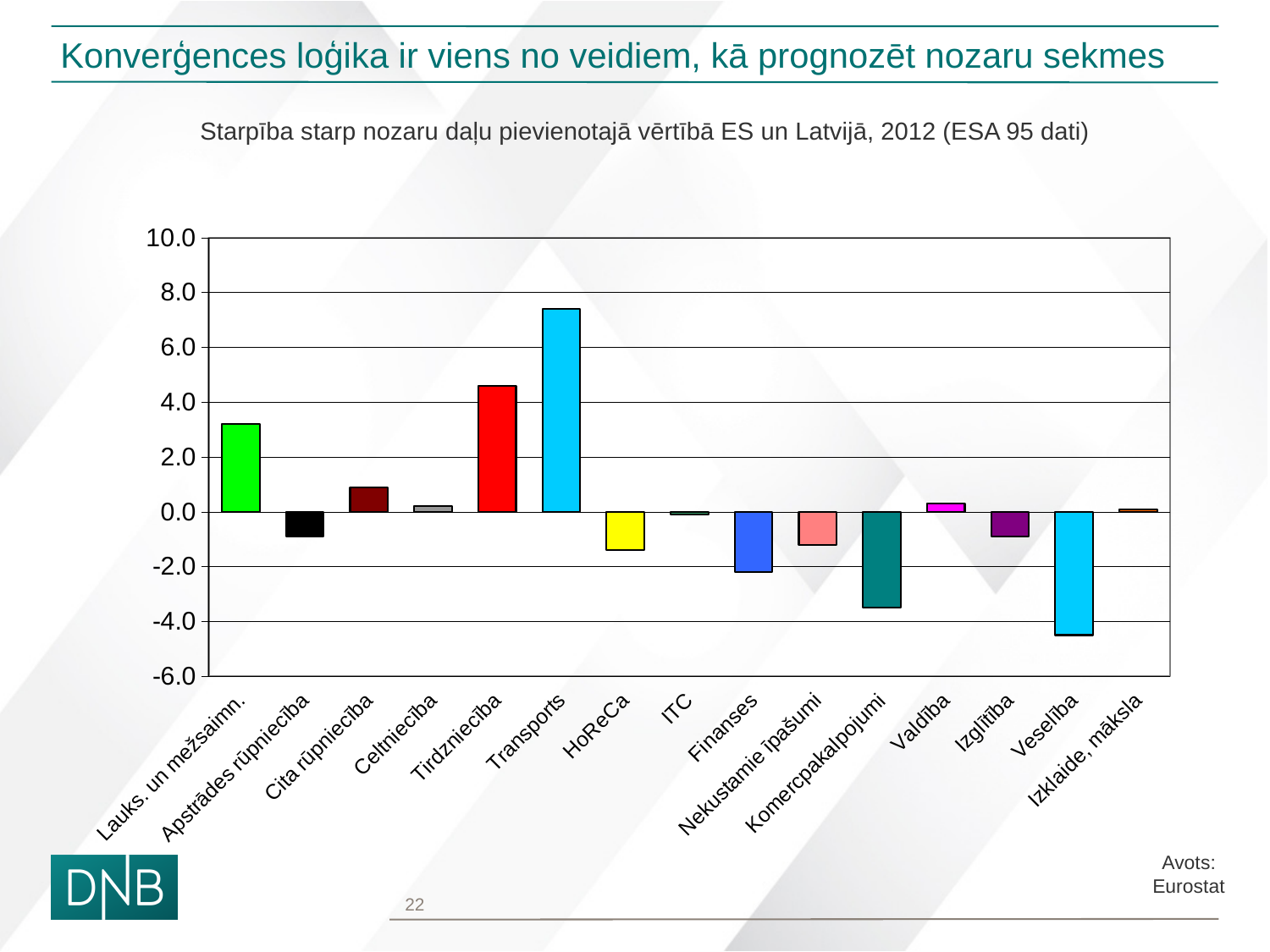
Which has the higher value, Finanses or Komercpakalpojumi? Finanses Is the value for Transports greater or less than 6.0? greater Is the value for Tirdzniecība greater or less than 4.0? greater What kind of chart is shown on the slide? bar chart How many categories (sectors) are shown on the x axis of the chart? 15 Is the value for Komercpakalpojumi greater or less than -2.0? less Which has the higher value, Transports or Tirdzniecība? Transports What is the subtitle describing the chart's data? Starpība starp nozaru daļu pievienotajā vērtībā ES un Latvijā, 2012 (ESA 95 dati) Which sector has the highest value in the chart? Transports Which sector has the lowest value in the chart? Veselība